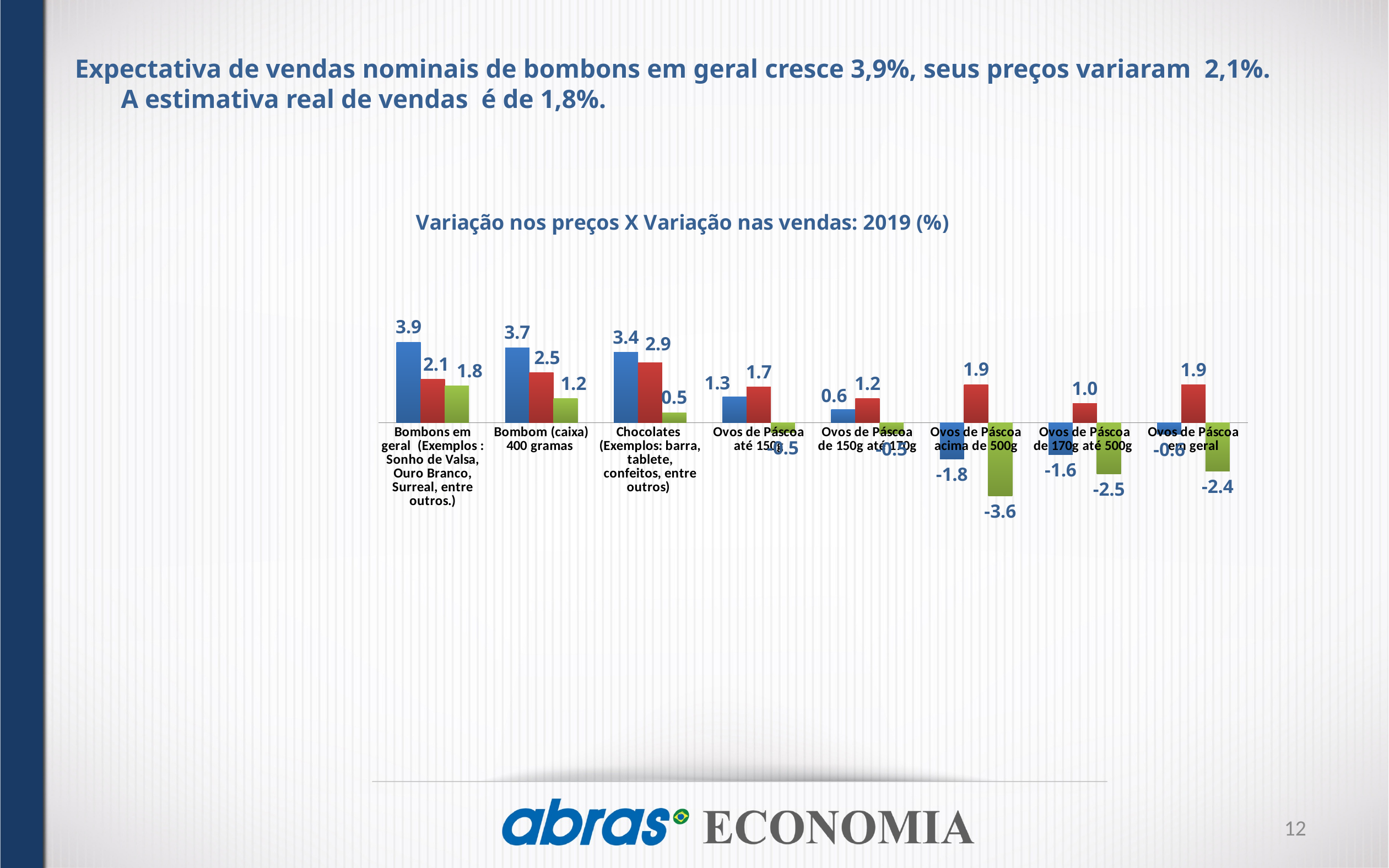
How many categories are shown on the x axis of the chart? 8 What is the value of the red bar for 'Bombom (caixa) 400 gramas'? 2.5 What is the value of the blue bar for 'Bombons em geral'? 3.9 Which category has the lowest green bar? Ovos de Páscoa acima de 500g What kind of chart is shown on the slide? bar chart What is the difference between the blue bar and the green bar for 'Bombons em geral'? 2.1 What is the value of the green bar for 'Ovos de Páscoa acima de 500g'? -3.6 What is the value of the red bar for 'Ovos de Páscoa em geral'? 1.9 Which is larger for 'Chocolates': the blue bar or the red bar? the blue bar What is the value of the blue bar for 'Ovos de Páscoa de 170g até 500g'? -1.6 Which category has the highest blue bar? Bombons em geral What is the title of the chart? Variação nos preços X Variação nas vendas: 2019 (%)